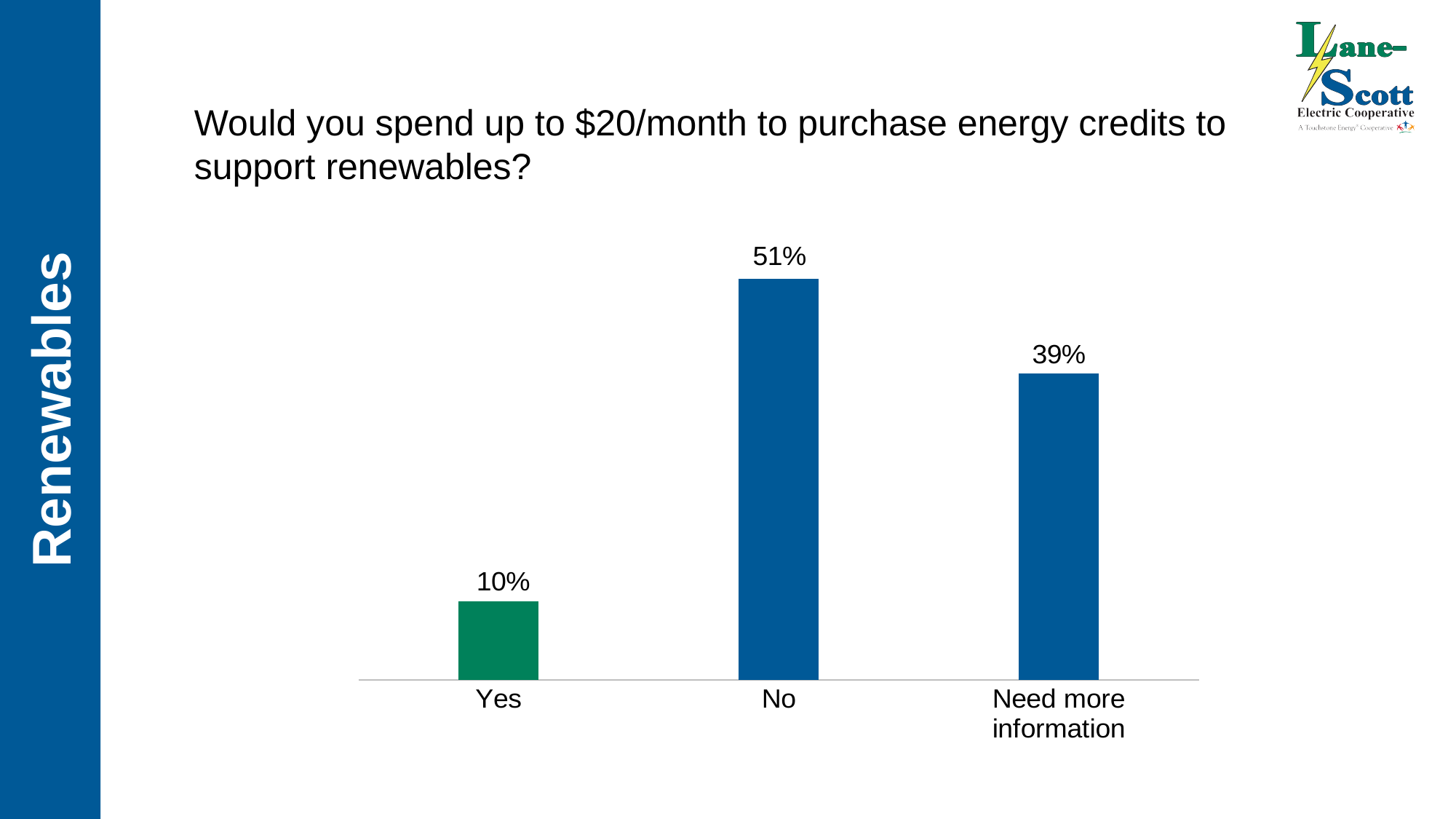
What is the difference in percentage points between "No" and "Need more information"? 12 Which response has the highest percentage? No What kind of chart is shown on the slide? Bar chart What percentage of respondents answered "Yes"? 10% Which is larger, the percentage for "Need more information" or for "Yes"? Need more information Which bar is shown in a different colour (green) from the others? Yes What percentage of respondents answered "No"? 51% Which response has the lowest percentage? Yes How many response categories are shown in the chart? 3 What is the difference in percentage points between "No" and "Yes"? 41 What percentage of respondents answered "Need more information"? 39% What survey question does the chart present? Would you spend up to $20/month to purchase energy credits to support renewables?